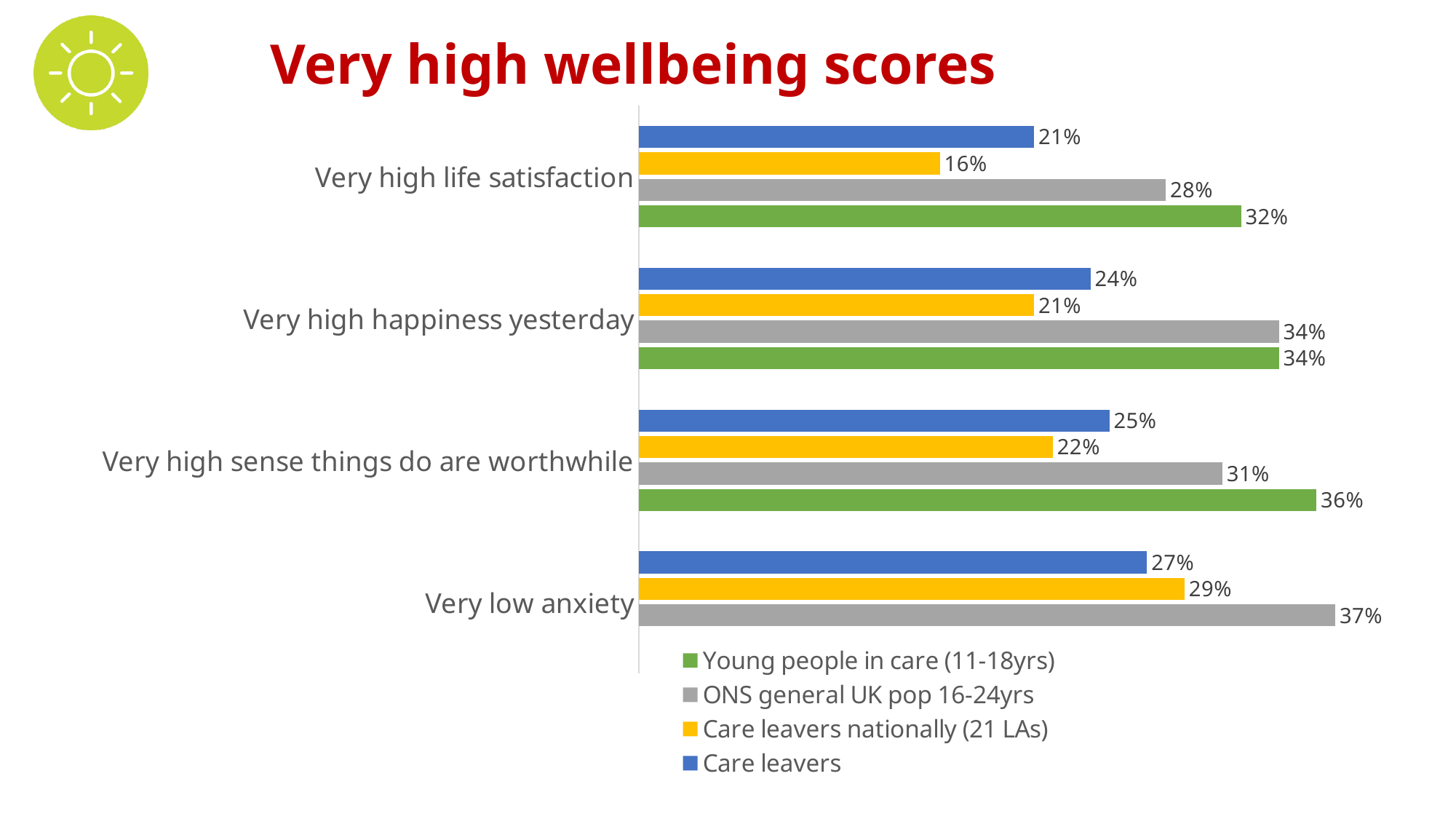
What is the value for Care leavers nationally (21 LAs) for Very high life satisfaction? 16% What kind of chart is shown on the slide? bar chart How many categories are shown on the chart? 4 What is the value for Young people in care (11-18yrs) for Very high sense things do are worthwhile? 36% Which series has the lowest value for Very high sense things do are worthwhile? Care leavers nationally (21 LAs) Which is larger for Very low anxiety: the Care leavers value or the Care leavers nationally (21 LAs) value? Care leavers nationally (21 LAs) What is the difference between the ONS general UK pop 16-24yrs value and the Care leavers value for Very low anxiety? 10% What is the value for ONS general UK pop 16-24yrs for Very low anxiety? 37% How many series does the legend list? 4 Which category has no bar for the Young people in care (11-18yrs) series? Very low anxiety What is the value for Care leavers for Very high happiness yesterday? 24% Which series has the highest value for Very high life satisfaction? Young people in care (11-18yrs)